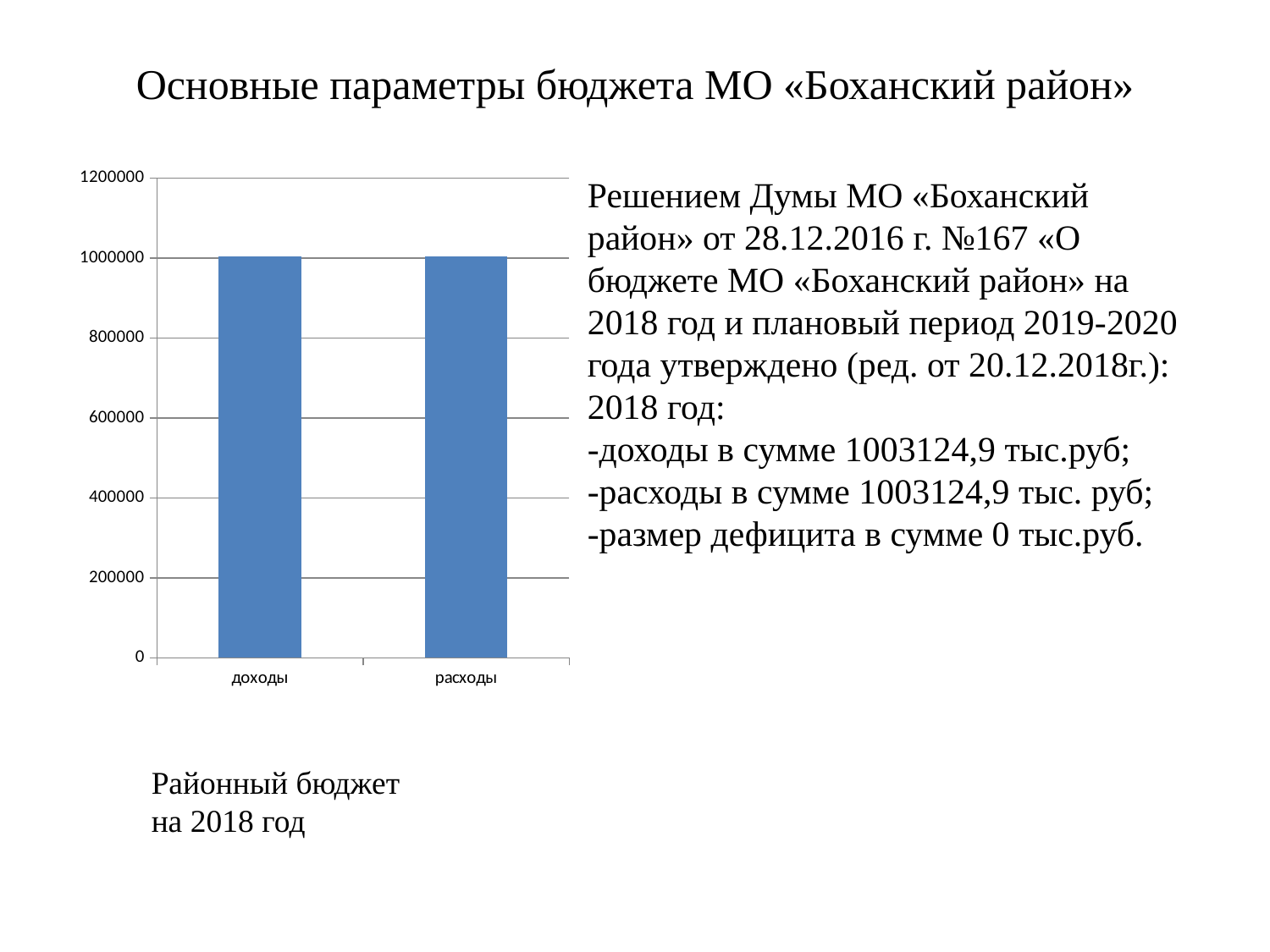
What is the highest tick value shown on the y axis of the chart? 1200000 Is the value for расходы greater or less than 800000? greater Is the value for расходы greater or less than 600000? greater Is the value for доходы greater or less than 800000? greater How many categories are plotted on the x axis of the chart? 2 What kind of chart is shown on the slide? bar chart According to the text on the slide, what is the size of the deficit for 2018? 0 тыс.руб What are the two category labels on the x axis of the chart? доходы, расходы According to the text on the slide, what is the sum of доходы for 2018? 1003124,9 тыс.руб